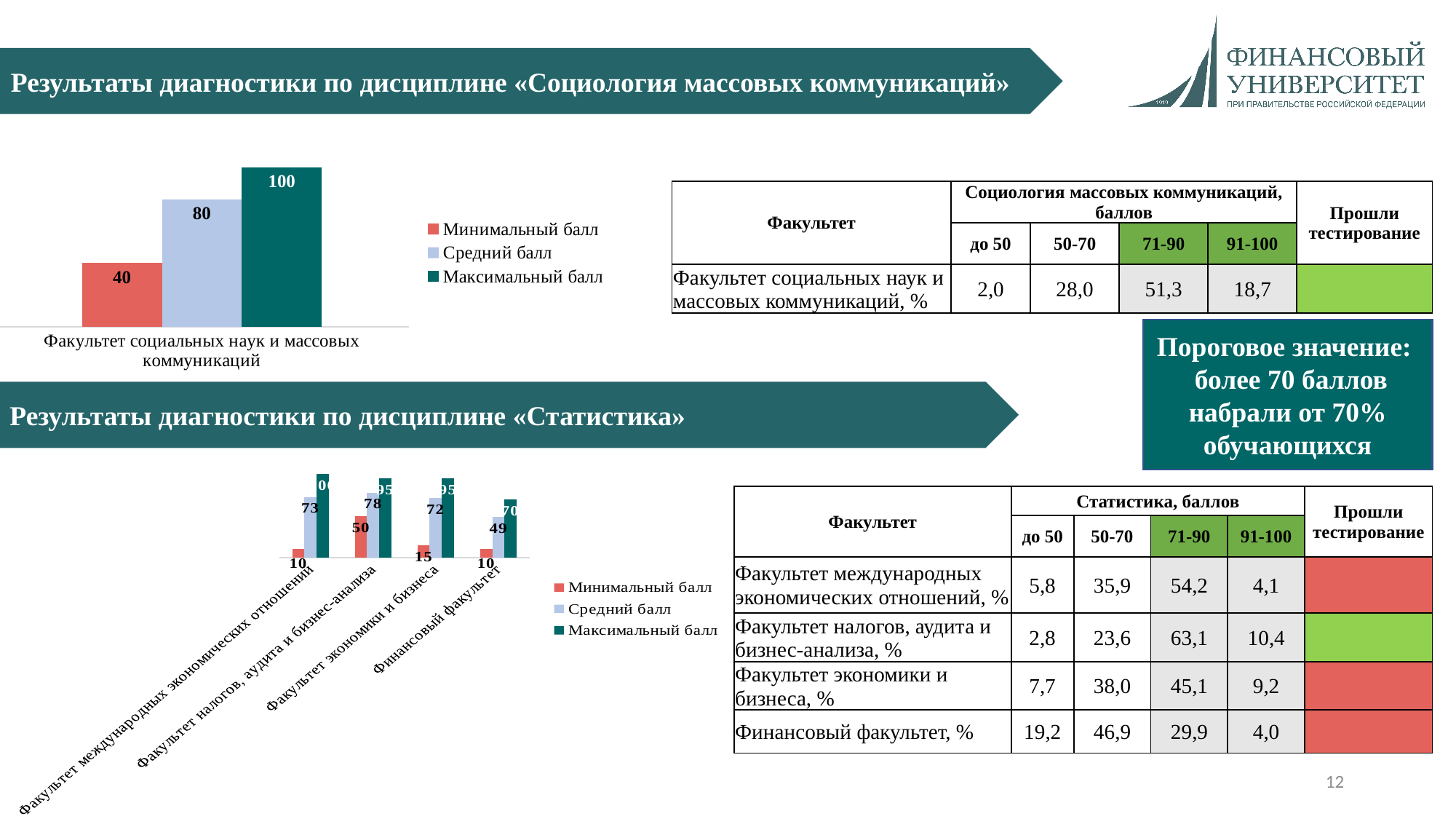
In the bottom chart (Статистика), which faculty has the lowest Средний балл? Финансовый факультет In the bottom chart (Статистика), which faculty has the highest Средний балл? Факультет налогов, аудита и бизнес-анализа In the bottom chart (Статистика), what is the Средний балл for Финансовый факультет? 49 In the top chart (Социология массовых коммуникаций), how many series does the legend list? 3 In the bottom chart (Статистика), which is larger: the Минимальный балл for Факультет экономики и бизнеса or for Финансовый факультет? Факультет экономики и бизнеса In the bottom chart (Статистика), how many faculties are shown on the x axis? 4 In the top chart (Социология массовых коммуникаций), what is the value of Минимальный балл? 40 In the top chart (Социология массовых коммуникаций), what is the difference between Максимальный балл and Минимальный балл? 60 In the bottom chart (Статистика), what is the difference between the Средний балл of Факультет налогов, аудита и бизнес-анализа and Финансовый факультет? 29 What kind of chart is the top chart (Социология массовых коммуникаций)? bar chart In the bottom chart (Статистика), what is the Минимальный балл for Факультет налогов, аудита и бизнес-анализа? 50 In the top chart (Социология массовых коммуникаций), what is the value of Средний балл for Факультет социальных наук и массовых коммуникаций? 80